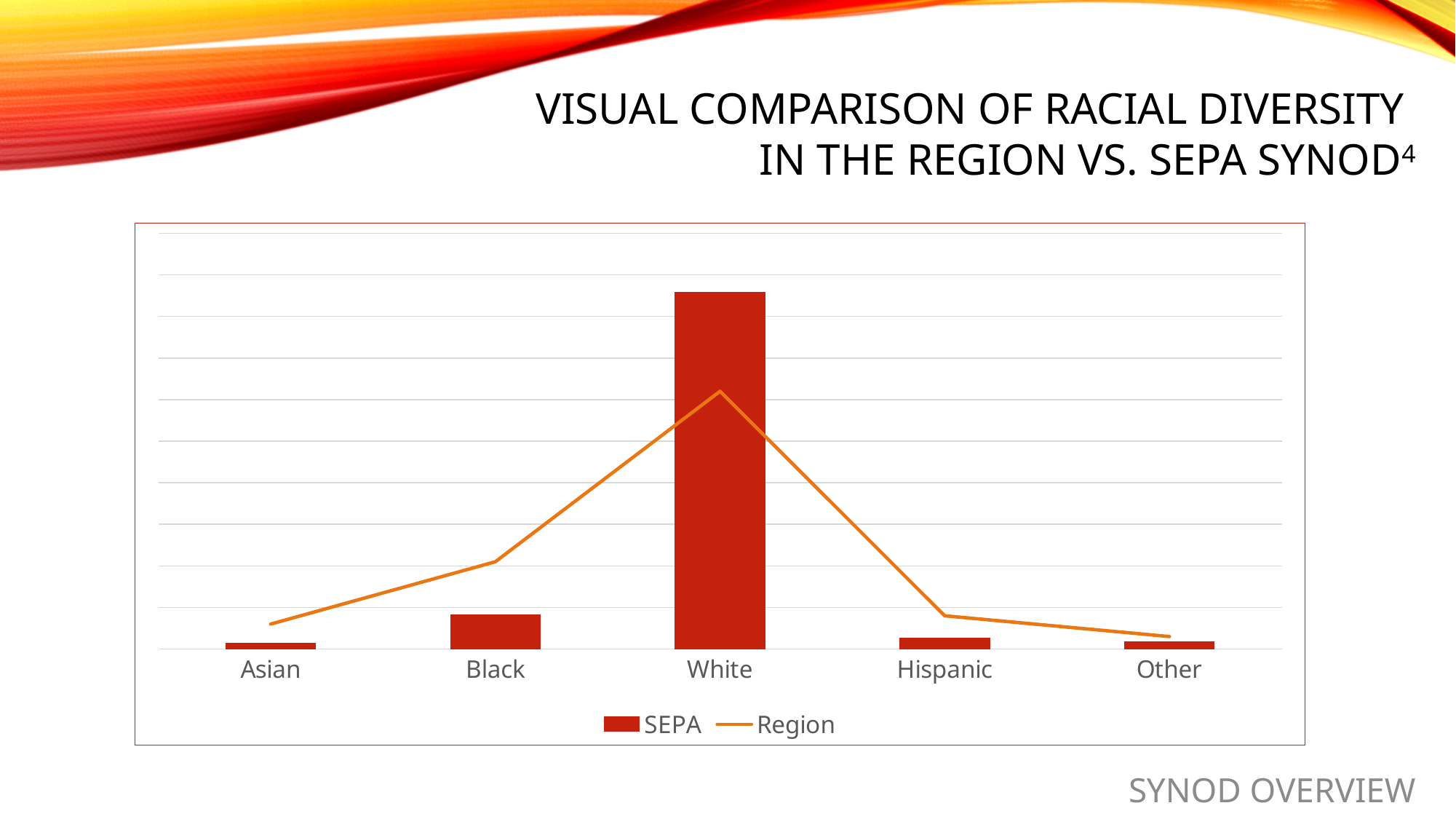
Which category has the highest SEPA value? White For the Asian category, which series has the larger value, SEPA or Region? Region How many racial categories are shown on the x axis? 5 Which series is drawn as a line rather than bars? Region Which category has the lowest Region value? Other What kind of chart is shown on the slide? A combination bar and line chart Which is larger for the Region series, the value for Black or the value for Hispanic? Black Which is larger for SEPA, the value for Black or the value for Hispanic? Black What are the two series named in the legend? SEPA and Region Which category has the highest Region value? White How many series does the legend list? 2